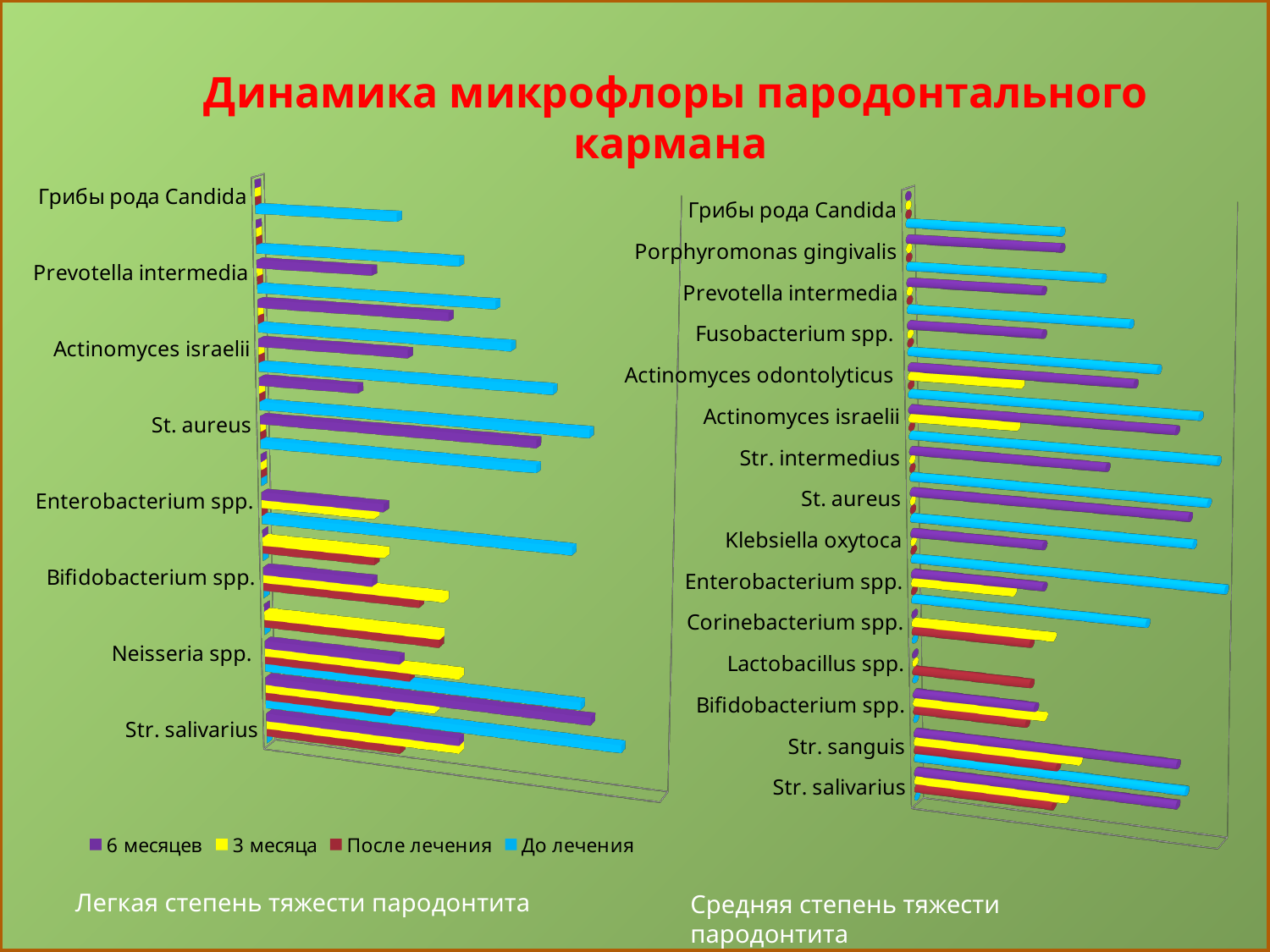
In the right chart (Средняя степень тяжести пародонтита), for Lactobacillus spp., which is larger: 'После лечения' or 'До лечения'? После лечения Which colour represents the series 'До лечения' in the legend? Blue In the left chart (Легкая степень тяжести пародонтита), for Грибы рода Candida, which is larger: 'До лечения' or '6 месяцев'? До лечения How many series does the legend list? 4 In the right chart (Средняя степень тяжести пародонтита), how many categories are plotted? 15 In the left chart (Легкая степень тяжести пародонтита), for Str. salivarius, which is larger: 'До лечения' or '3 месяца'? 3 месяца What kind of chart is the right chart (Средняя степень тяжести пародонтита)? Bar chart What is the title of the slide? Динамика микрофлоры пародонтального кармана What kind of chart is the left chart (Легкая степень тяжести пародонтита)? Bar chart